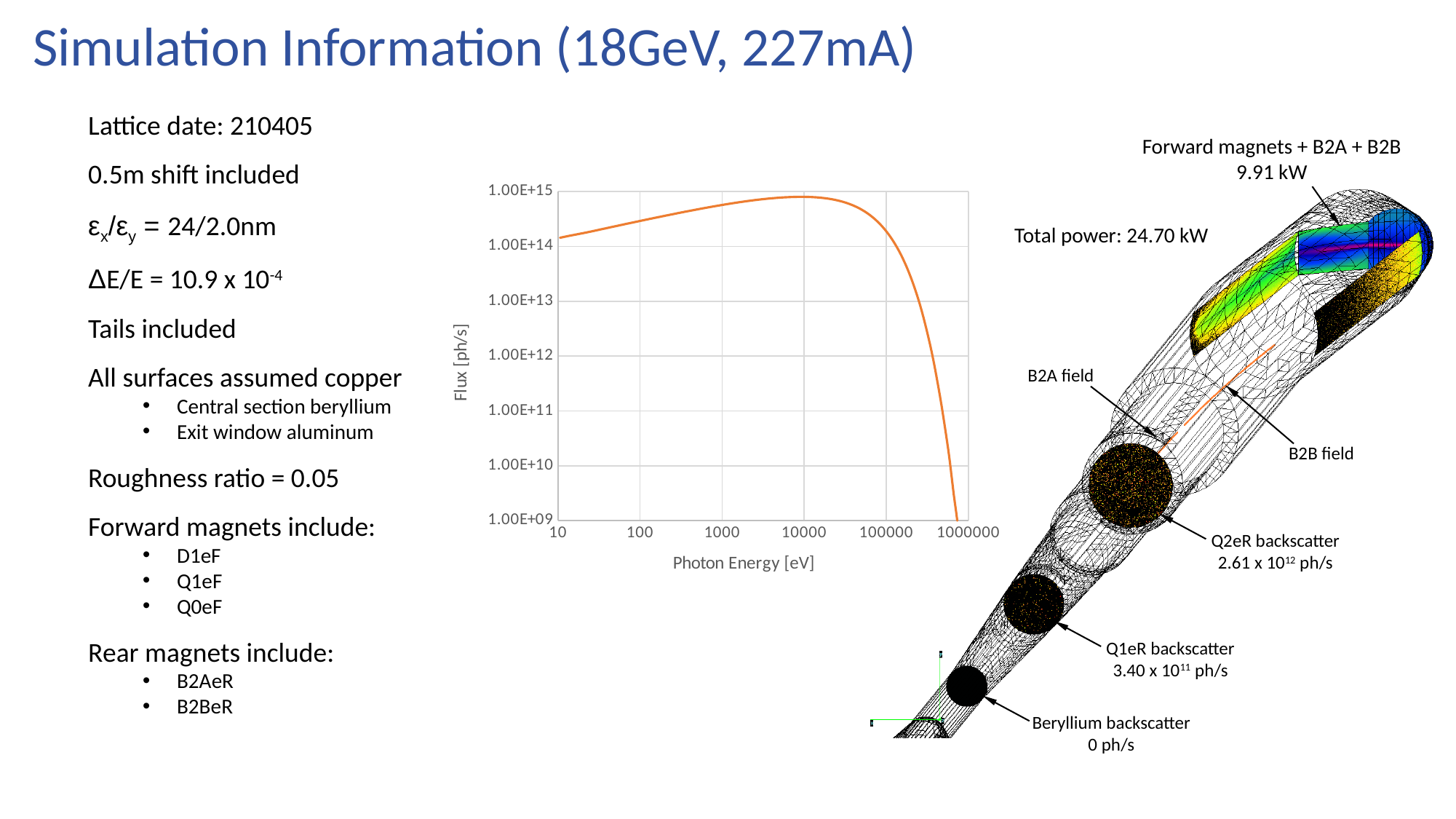
In the flux chart, does the flux rise or fall as photon energy increases from 100000 eV to 1000000 eV? fall How many tick labels are shown on the x axis of the flux chart? 6 How many lines are plotted in the flux chart? 1 In the flux chart, does the flux rise or fall as photon energy increases from 10 eV to 1000 eV? rise In the flux chart, is the flux higher at 10000 eV or at 1000000 eV? 10000 eV In the flux chart, is the flux at a photon energy of 10000 eV greater or less than 1.00E+14 ph/s? greater In the flux chart, is the flux at a photon energy of 100000 eV greater or less than 1.00E+13 ph/s? greater In the flux chart, is the flux near a photon energy of 1000000 eV greater or less than 1.00E+10 ph/s? less What is the label of the y axis of the flux chart? Flux [ph/s] What is the label of the x axis of the flux chart? Photon Energy [eV] What kind of chart is shown in the middle of the slide? line chart